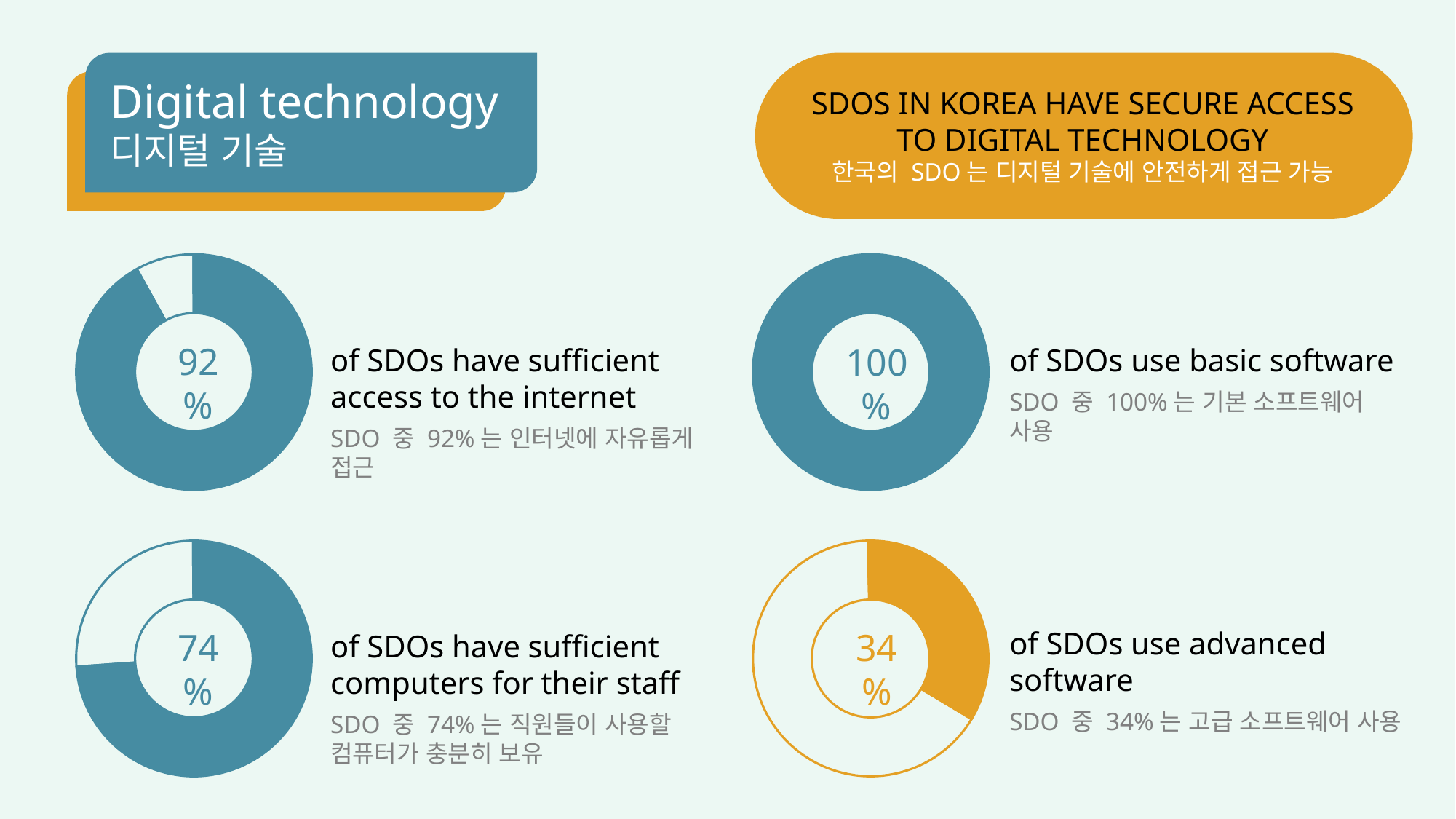
Which of the four donut charts shows the highest percentage? of SDOs use basic software (100%) What percentage of SDOs use basic software, according to the top-right donut chart? 100% What kind of chart is used to show the percentage of SDOs that use advanced software? donut (pie) chart Which is larger: the percentage of SDOs with sufficient internet access or the percentage with sufficient computers for their staff? sufficient internet access (92%) What percentage of SDOs have sufficient access to the internet, according to the top-left donut chart? 92% How many donut charts are shown on the slide? 4 What is the difference between the percentage of SDOs that use basic software and the percentage that use advanced software? 66% What percentage of SDOs have sufficient computers for their staff, according to the bottom-left donut chart? 74% What is the difference between the percentage of SDOs with sufficient internet access and the percentage with sufficient computers for their staff? 18% Which of the four donut charts shows the lowest percentage? of SDOs use advanced software (34%) What percentage of SDOs use advanced software, according to the bottom-right donut chart? 34% Which donut chart on the slide is coloured orange rather than blue? of SDOs use advanced software (34%)